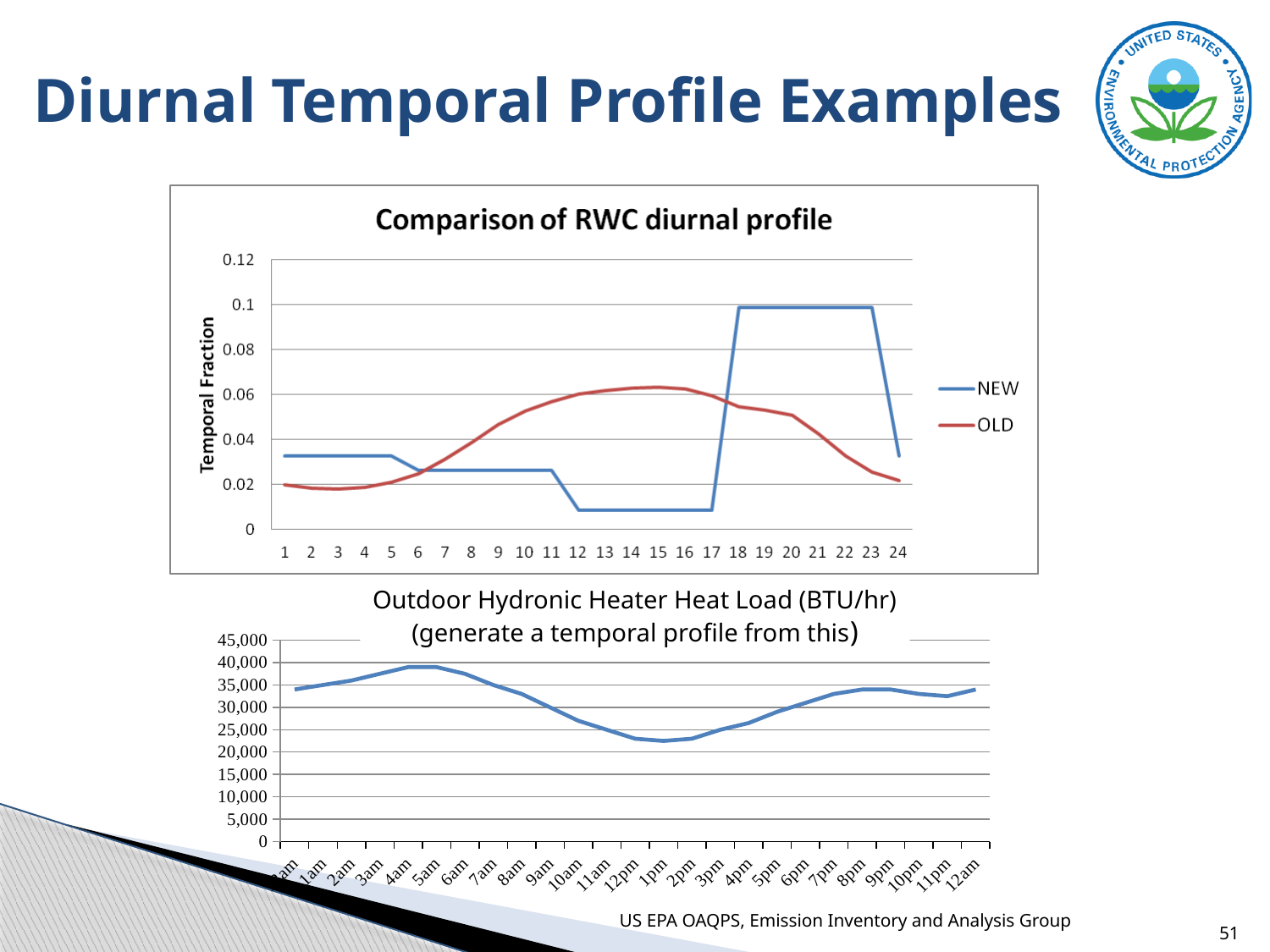
In the 'Comparison of RWC diurnal profile' chart, is the NEW value at hour 20 greater or less than 0.08? greater In the 'Comparison of RWC diurnal profile' chart, which series has the larger value at hour 15, NEW or OLD? OLD In the 'Comparison of RWC diurnal profile' chart, which series has the larger value at hour 20, NEW or OLD? NEW In the 'Comparison of RWC diurnal profile' chart, is the OLD value at hour 15 greater or less than 0.04? greater How many series does the legend of the 'Comparison of RWC diurnal profile' chart list? 2 What kind of chart is the 'Comparison of RWC diurnal profile' chart? line chart In the 'Outdoor Hydronic Heater Heat Load (BTU/hr)' chart, do the values rise or fall from 5am to 1pm? fall In the 'Comparison of RWC diurnal profile' chart, what colour is the NEW line? blue In the 'Comparison of RWC diurnal profile' chart, is the NEW value at hour 13 greater or less than 0.02? less What kind of chart is the 'Outdoor Hydronic Heater Heat Load (BTU/hr)' chart? line chart In the 'Comparison of RWC diurnal profile' chart, how many hours are shown on the x axis? 24